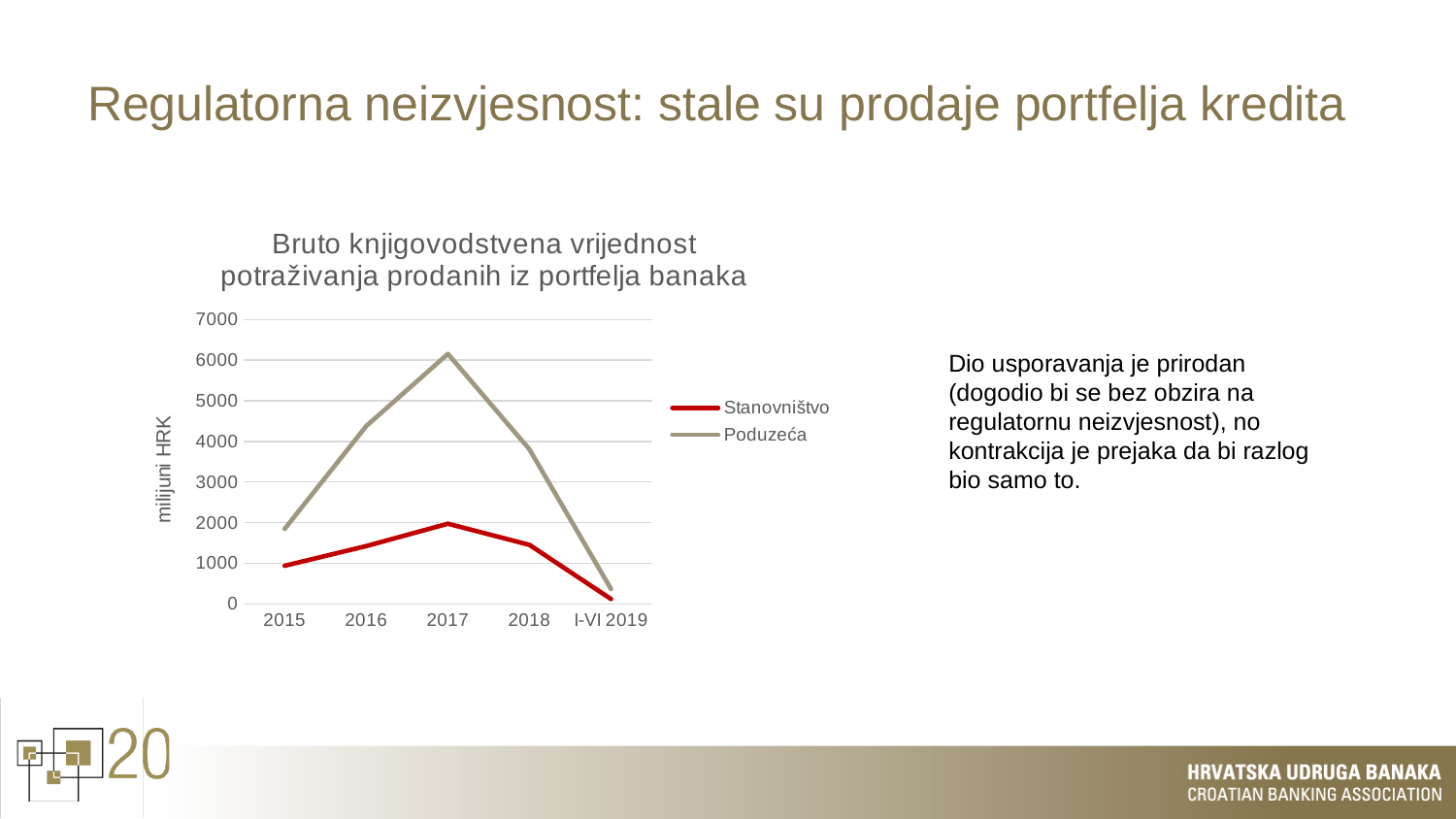
How many series does the legend list? 2 Does the Poduzeća series rise or fall between 2017 and I-VI 2019? fall Is the value for Poduzeća in 2016 greater or less than 4000? greater What kind of chart is shown on the slide? line chart In which period does the Poduzeća series reach its highest value? 2017 What unit is shown on the y axis label of the chart? milijuni HRK Which series has the higher value in 2017, Stanovništvo or Poduzeća? Poduzeća In which period does the Poduzeća series reach its lowest value? I-VI 2019 In which period does the Stanovništvo series reach its lowest value? I-VI 2019 Is the value for Poduzeća in 2017 greater or less than 6000? greater How many periods are shown on the x axis? 5